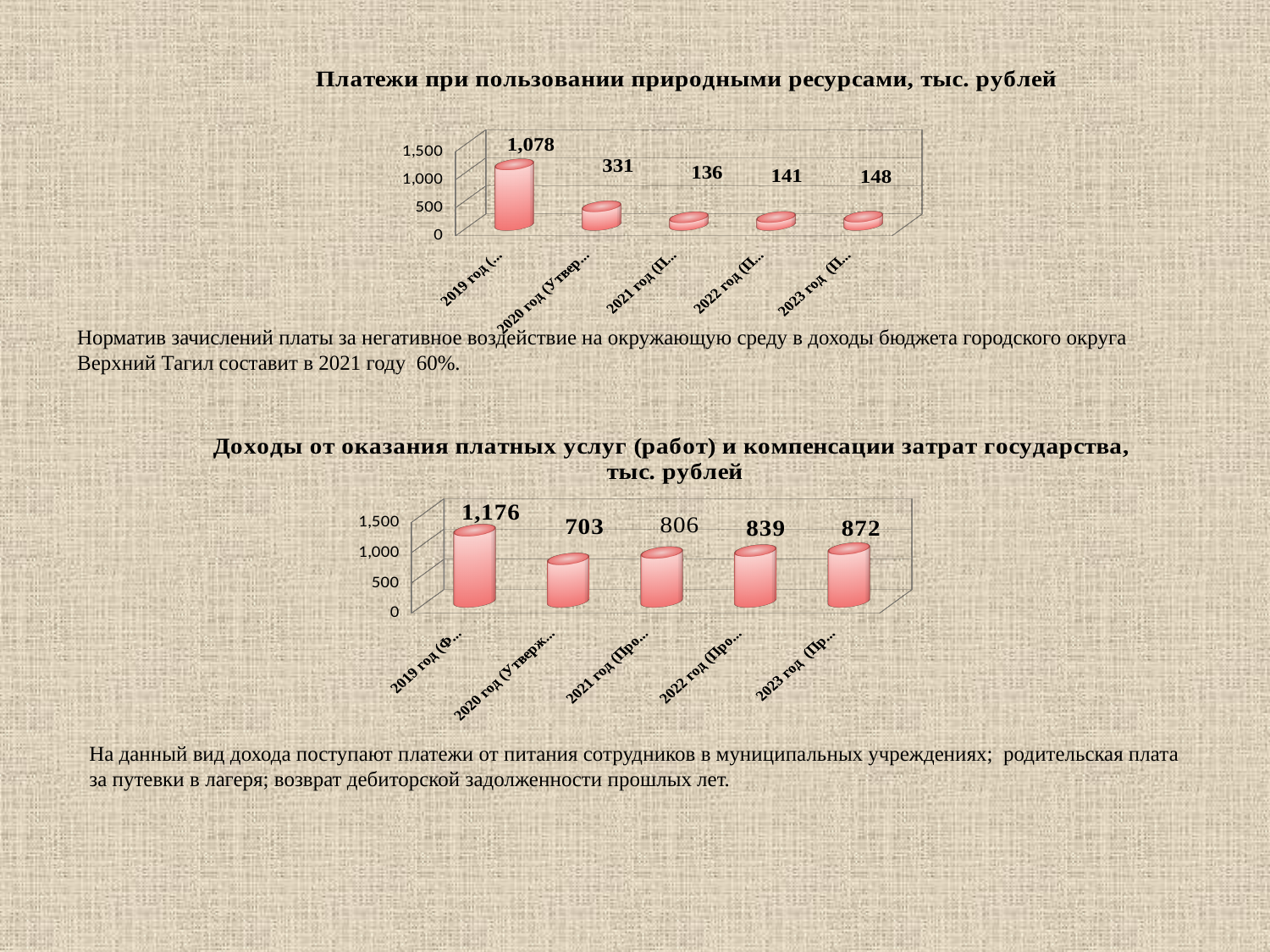
In the bottom chart (Доходы от оказания платных услуг), what is the difference between the values for 2023 год and 2022 год? 33 In the bottom chart (Доходы от оказания платных услуг), is the value for 2022 год larger or smaller than the value for 2021 год? larger In the top chart (Платежи при пользовании природными ресурсами), how many bars are plotted? 5 In the top chart (Платежи при пользовании природными ресурсами), what is the value for 2021 год? 136 What type of chart is the top chart on the slide? bar chart In the top chart (Платежи при пользовании природными ресурсами), what is the difference between the values for 2019 год and 2020 год? 747 In the bottom chart (Доходы от оказания платных услуг), do the values rise or fall from 2020 год to 2023 год? rise In the bottom chart (Доходы от оказания платных услуг), which year has the highest value? 2019 год In the bottom chart (Доходы от оказания платных услуг), what is the value for 2020 год? 703 In the bottom chart (Доходы от оказания платных услуг), what is the value for 2023 год? 872 In the top chart (Платежи при пользовании природными ресурсами), which year has the lowest value? 2021 год In the top chart (Платежи при пользовании природными ресурсами), what is the value for 2019 год? 1,078